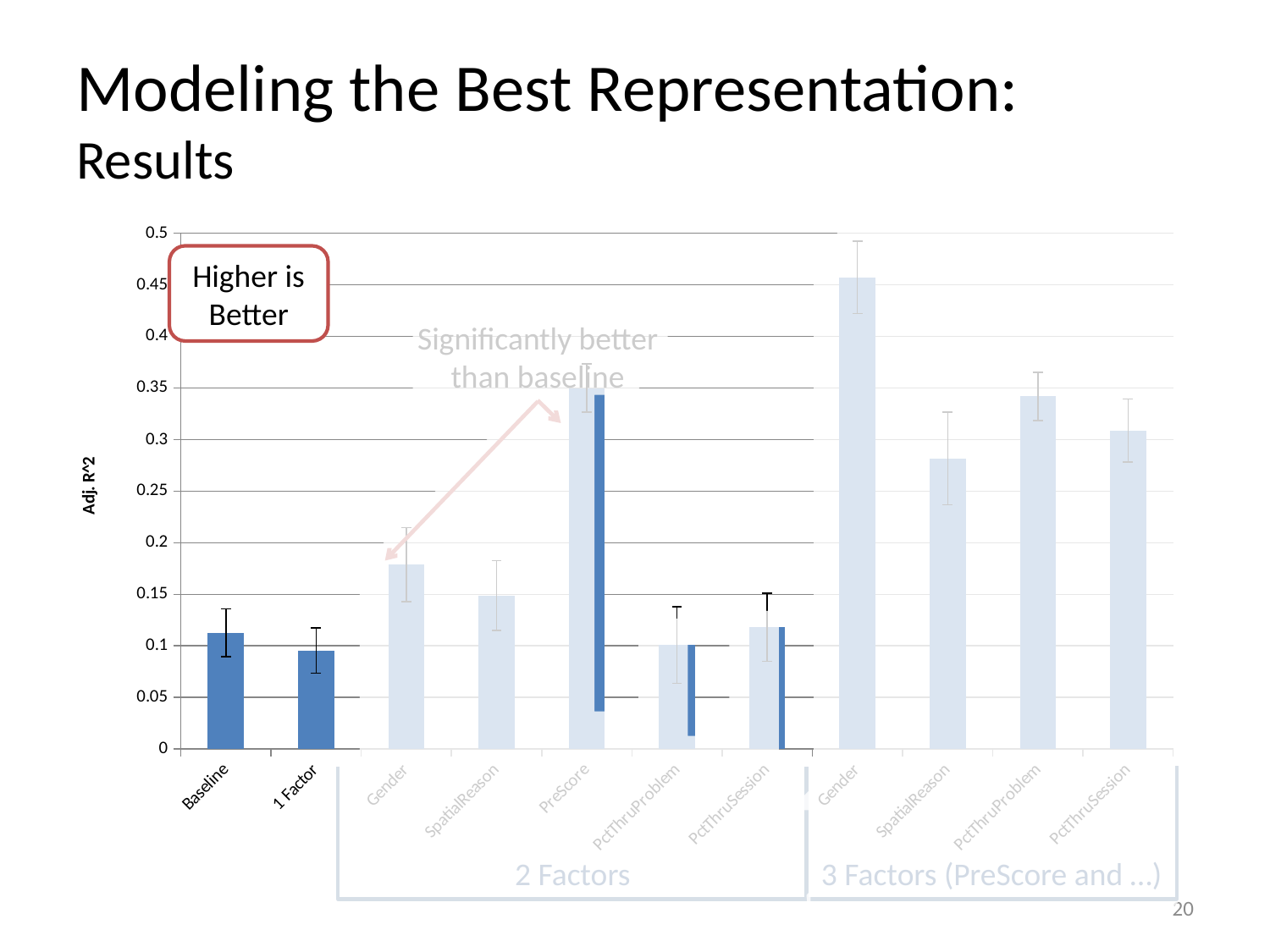
Is the value for Gender in the 3 Factors group greater or less than 0.4? greater Is the value for Baseline greater or less than 0.15? less Which bar has the highest Adj. R^2 value? Gender (3 Factors) How many bars are in the "3 Factors (PreScore and ...)" group? 4 Is the value for PreScore in the 2 Factors group greater or less than 0.3? greater What kind of chart is shown on the slide? bar chart How many bars are in the "2 Factors" group? 5 Which is larger, the value for SpatialReason in the 2 Factors group or in the 3 Factors group? 3 Factors Which is larger, the value for PreScore (2 Factors) or the value for Baseline? PreScore (2 Factors) What is the label of the vertical axis? Adj. R^2 How many bars are plotted in the chart? 11